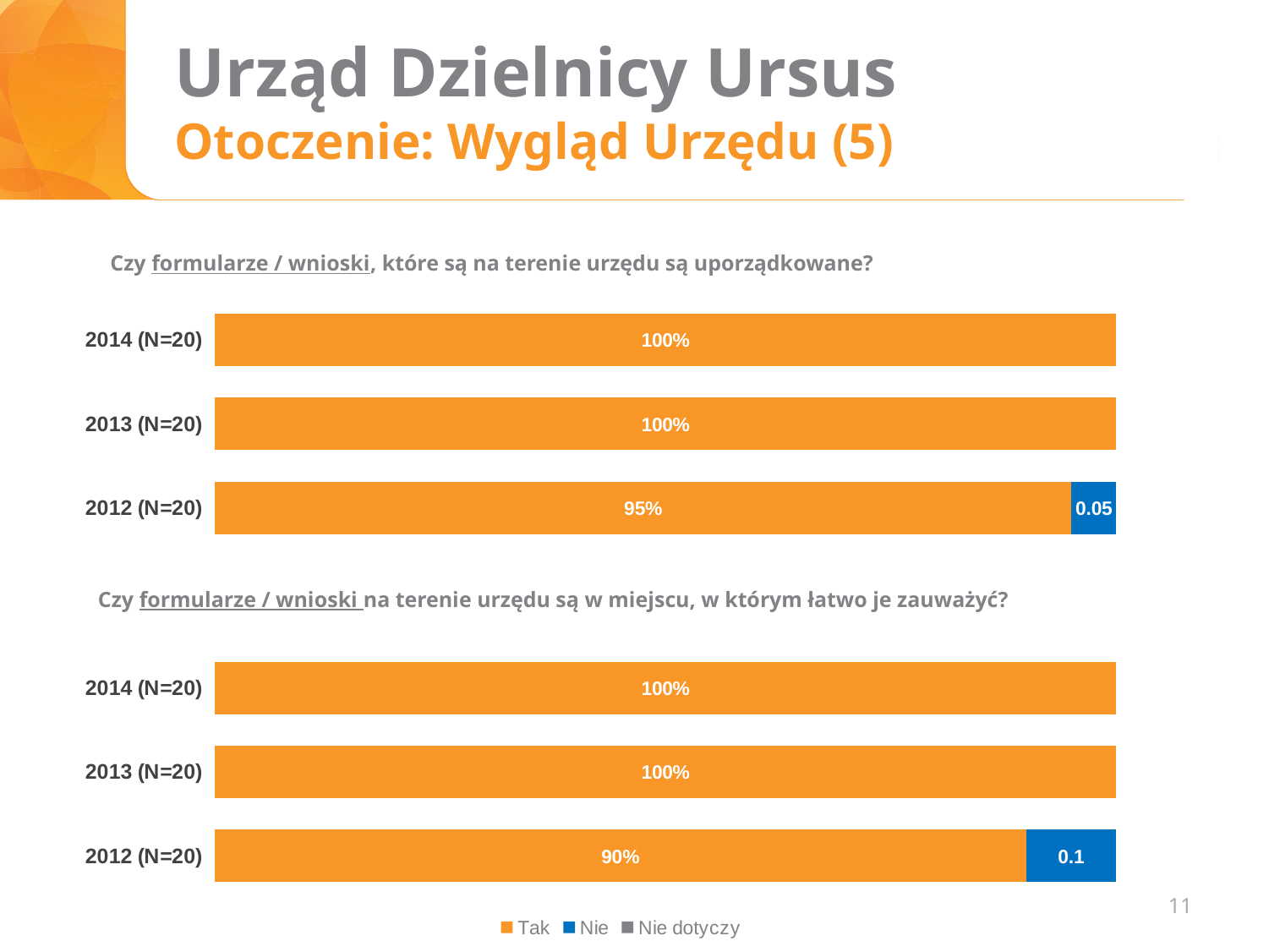
How many categories (years) are shown in the top chart ("Czy formularze / wnioski, które są na terenie urzędu są uporządkowane?")? 3 In the bottom chart ("Czy formularze / wnioski na terenie urzędu są w miejscu, w którym łatwo je zauważyć?"), what is the value of "Tak" for 2013 (N=20)? 100% In the top chart ("Czy formularze / wnioski, które są na terenie urzędu są uporządkowane?"), what is the value of "Tak" for 2012 (N=20)? 95% In the bottom chart ("Czy formularze / wnioski na terenie urzędu są w miejscu, w którym łatwo je zauważyć?"), what is the value of "Tak" for 2012 (N=20)? 90% In the top chart ("Czy formularze / wnioski, które są na terenie urzędu są uporządkowane?"), what label is shown on the "Nie" segment for 2012 (N=20)? 0.05 In the top chart ("Czy formularze / wnioski, które są na terenie urzędu są uporządkowane?"), what is the value of "Tak" for 2014 (N=20)? 100% In the top chart ("Czy formularze / wnioski, które są na terenie urzędu są uporządkowane?"), which year has the lowest "Tak" value? 2012 (N=20) In the bottom chart ("Czy formularze / wnioski na terenie urzędu są w miejscu, w którym łatwo je zauważyć?"), what label is shown on the "Nie" segment for 2012 (N=20)? 0.1 In the bottom chart ("Czy formularze / wnioski na terenie urzędu są w miejscu, w którym łatwo je zauważyć?"), which year has the lowest "Tak" value? 2012 (N=20) In the top chart ("Czy formularze / wnioski, które są na terenie urzędu są uporządkowane?"), what is the difference between the "Tak" value for 2013 (N=20) and for 2012 (N=20)? 5% In the bottom chart ("Czy formularze / wnioski na terenie urzędu są w miejscu, w którym łatwo je zauważyć?"), what is the difference between the "Tak" value for 2014 (N=20) and for 2012 (N=20)? 10% How many series does the legend at the bottom of the slide list? 3